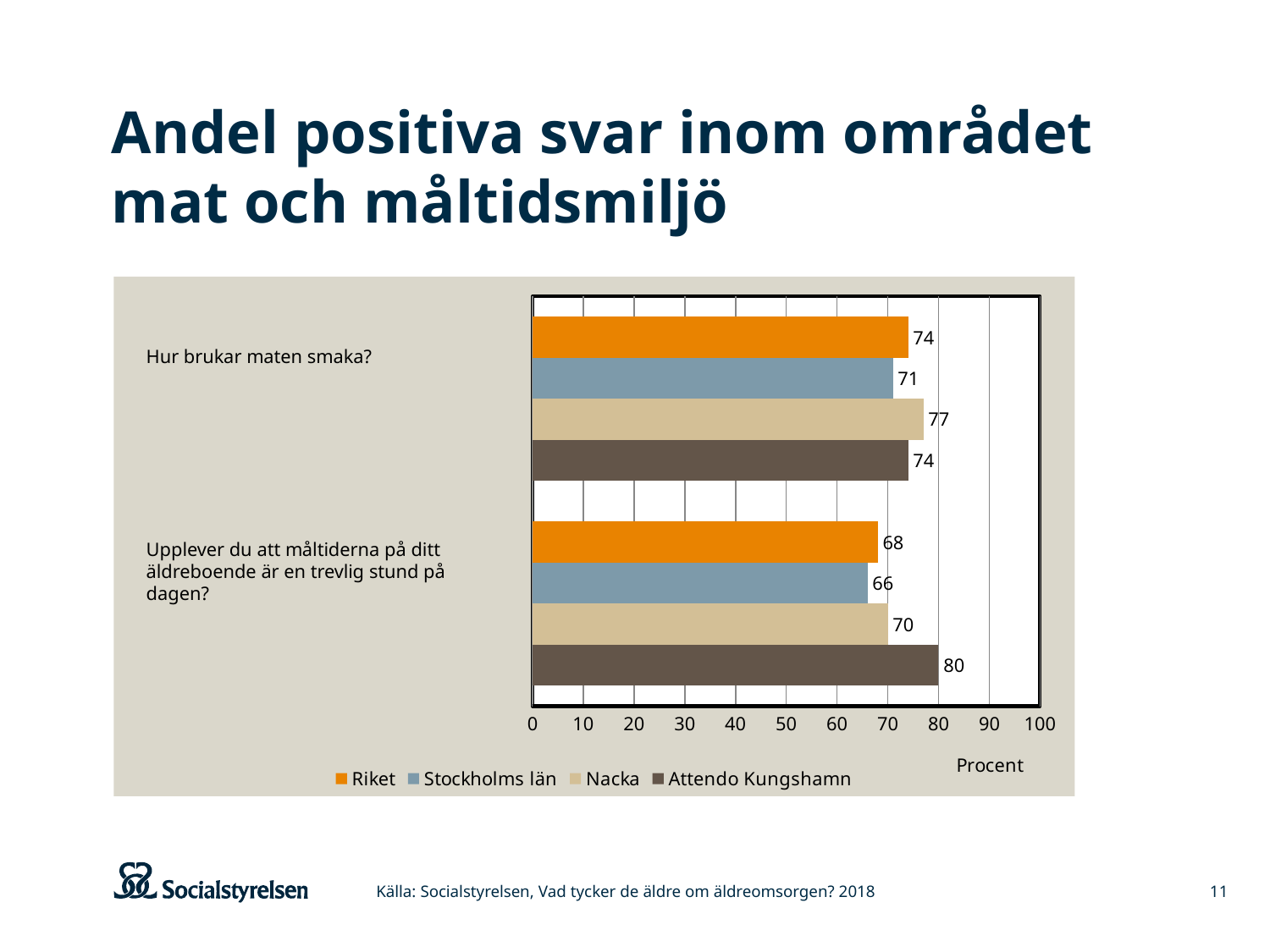
Which series has the highest value on the question "Hur brukar maten smaka?"? Nacka What is the value for Attendo Kungshamn on the question "Upplever du att måltiderna på ditt äldreboende är en trevlig stund på dagen?"? 80 What is the label on the horizontal axis of the chart? Procent What is the difference between the Attendo Kungshamn value and the Riket value on the question "Upplever du att måltiderna på ditt äldreboende är en trevlig stund på dagen?"? 12 How many series does the legend list? 4 How many questions (categories) are shown on the chart? 2 Which series has the lowest value on the question "Upplever du att måltiderna på ditt äldreboende är en trevlig stund på dagen?"? Stockholms län What is the value for Riket on the question "Upplever du att måltiderna på ditt äldreboende är en trevlig stund på dagen?"? 68 What kind of chart is shown on the slide? Bar chart Which is larger on the question "Hur brukar maten smaka?": the value for Riket or the value for Stockholms län? Riket What is the value for Stockholms län on the question "Hur brukar maten smaka?"? 71 What is the value for Nacka on the question "Hur brukar maten smaka?"? 77